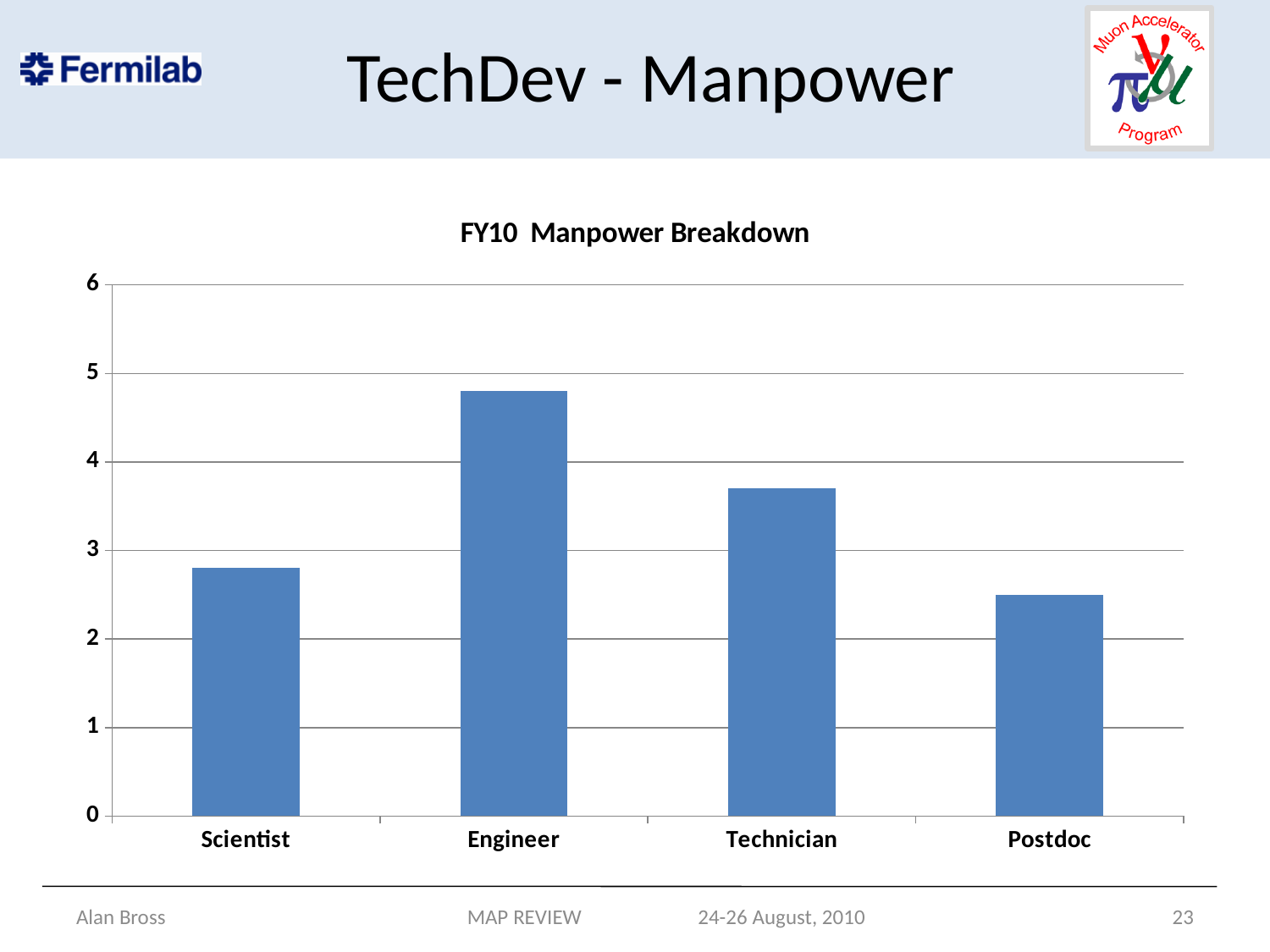
Which category has the lowest value in the FY10 Manpower Breakdown chart? Postdoc Is the value for Technician greater or less than 3? greater Which is larger, the value for Engineer or the value for Technician? Engineer Is the value for Engineer greater or less than 4? greater Is the value for Postdoc greater or less than 2? greater Which category has the highest value in the FY10 Manpower Breakdown chart? Engineer What type of chart is shown on the slide? bar chart What is the highest value shown on the y axis of the chart? 6 Which is larger, the value for Technician or the value for Scientist? Technician What is the title of the chart? FY10 Manpower Breakdown How many categories are shown on the x axis of the chart? 4